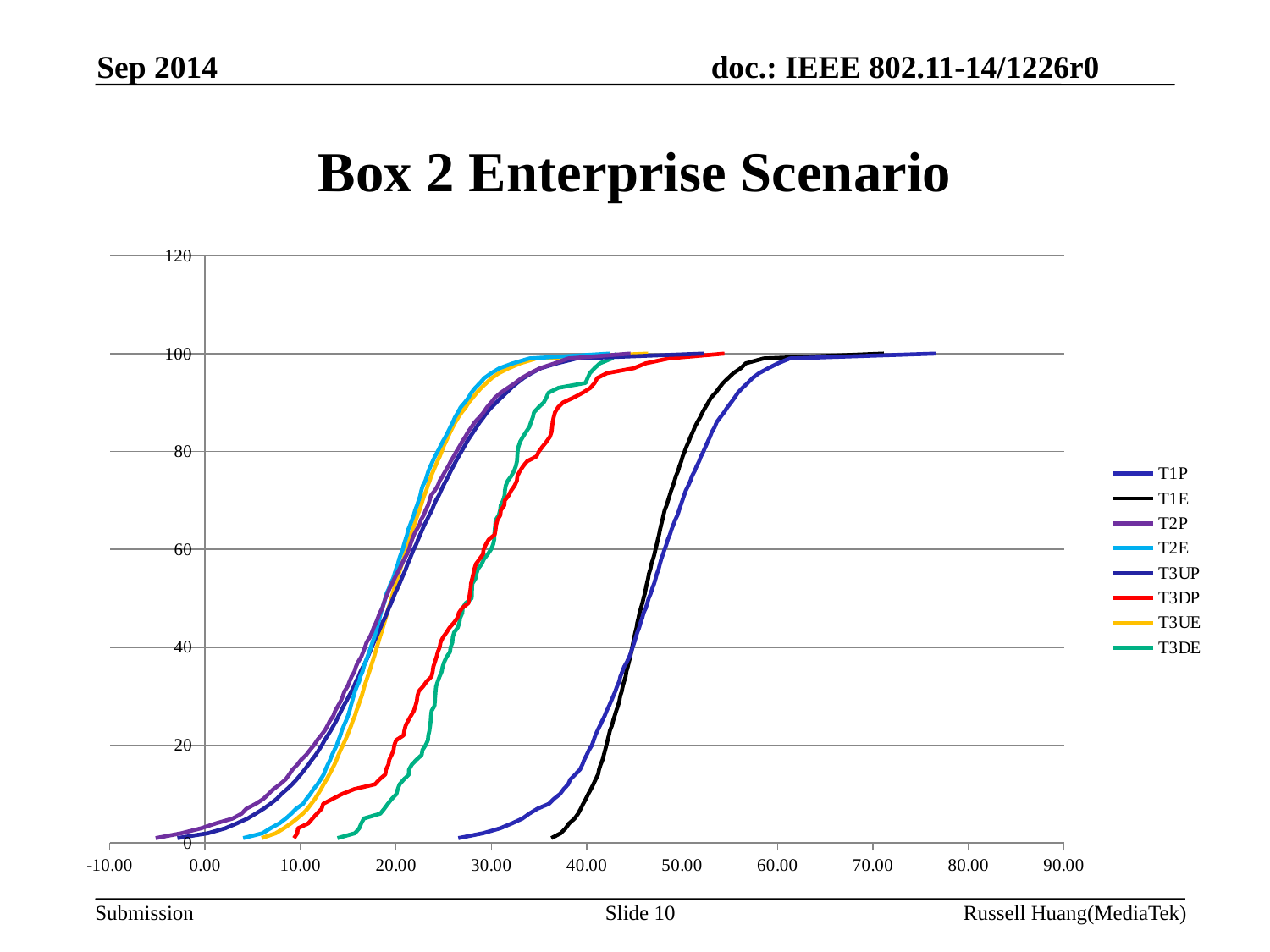
Is the value of the T3DP line at x = 20.00 greater or less than 40? less How many series does the legend list? 8 What colour is the T1E line in the chart? black Is the value of the T1E line at x = 40.00 greater or less than 20? less Is the value of the T2E line at x = 30.00 greater or less than 80? greater What is the title of the chart? Box 2 Enterprise Scenario Do the curves rise or fall as the x-axis value increases? rise What kind of chart is shown on the slide? line chart